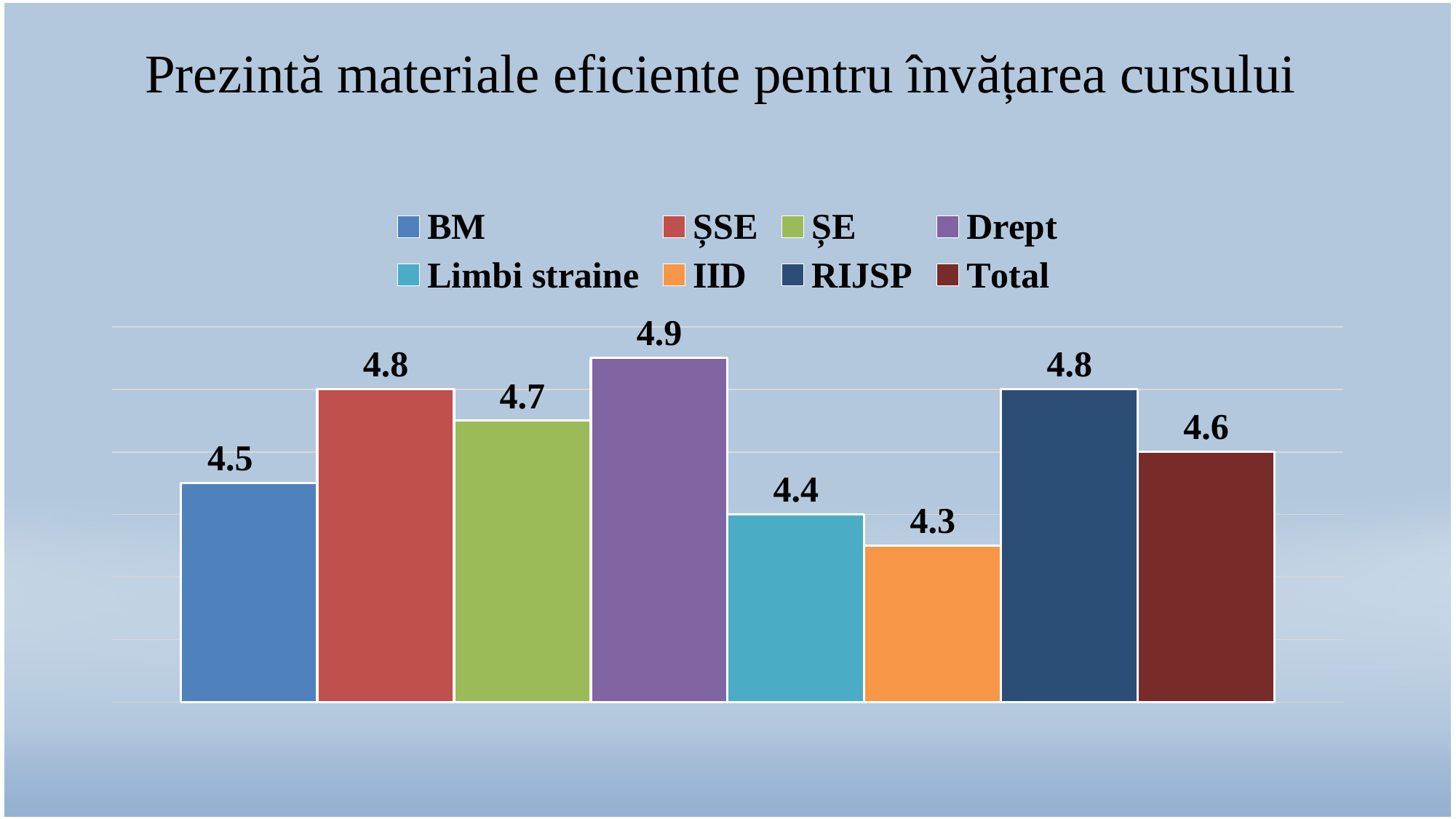
How many series does the legend list? 8 What kind of chart is shown on the slide? bar chart What is the value for Total? 4.6 What is the difference between the values for ȘSE and BM? 0.3 What is the value for Drept? 4.9 How many bars are plotted in the chart? 8 Which is larger, the value for ȘE or the value for Limbi straine? ȘE What is the value for Limbi straine? 4.4 What is the difference between the values for Drept and IID? 0.6 What is the title of the chart? Prezintă materiale eficiente pentru învățarea cursului Which series has the highest value? Drept Which series has the lowest value? IID